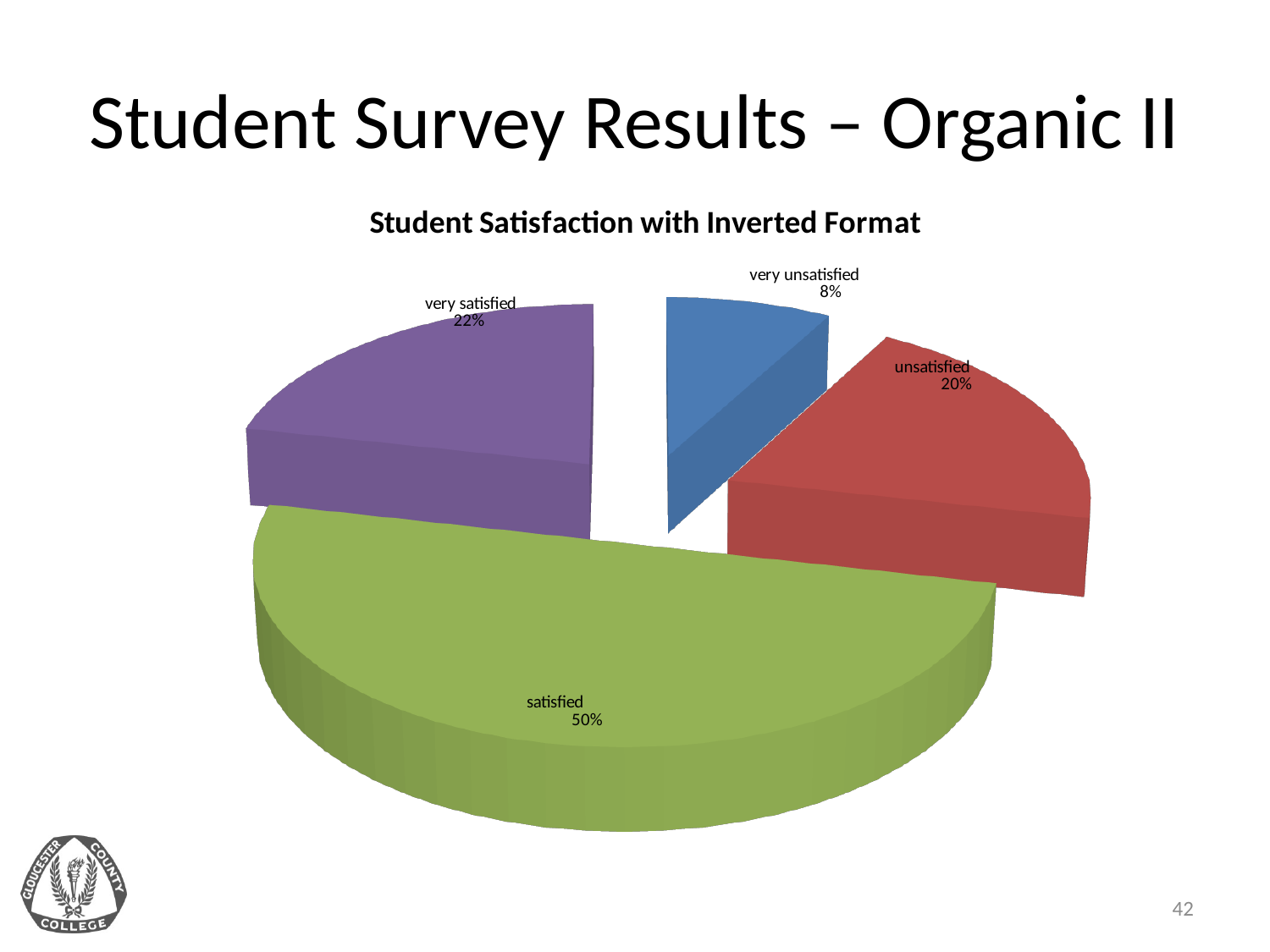
What is the title of the chart? Student Satisfaction with Inverted Format How many categories are shown in the pie chart? 4 What colour is the slice for satisfied? green What type of chart is shown on the slide? pie chart What is the difference in percentage points between satisfied and very satisfied? 28 Which category has the smallest share of the pie? very unsatisfied Which is larger, the share for very satisfied or the share for unsatisfied? very satisfied What percentage of students were very satisfied? 22% What percentage of students were very unsatisfied? 8% What percentage of students were unsatisfied? 20% Which category has the largest share of the pie? satisfied What percentage of students were satisfied? 50%